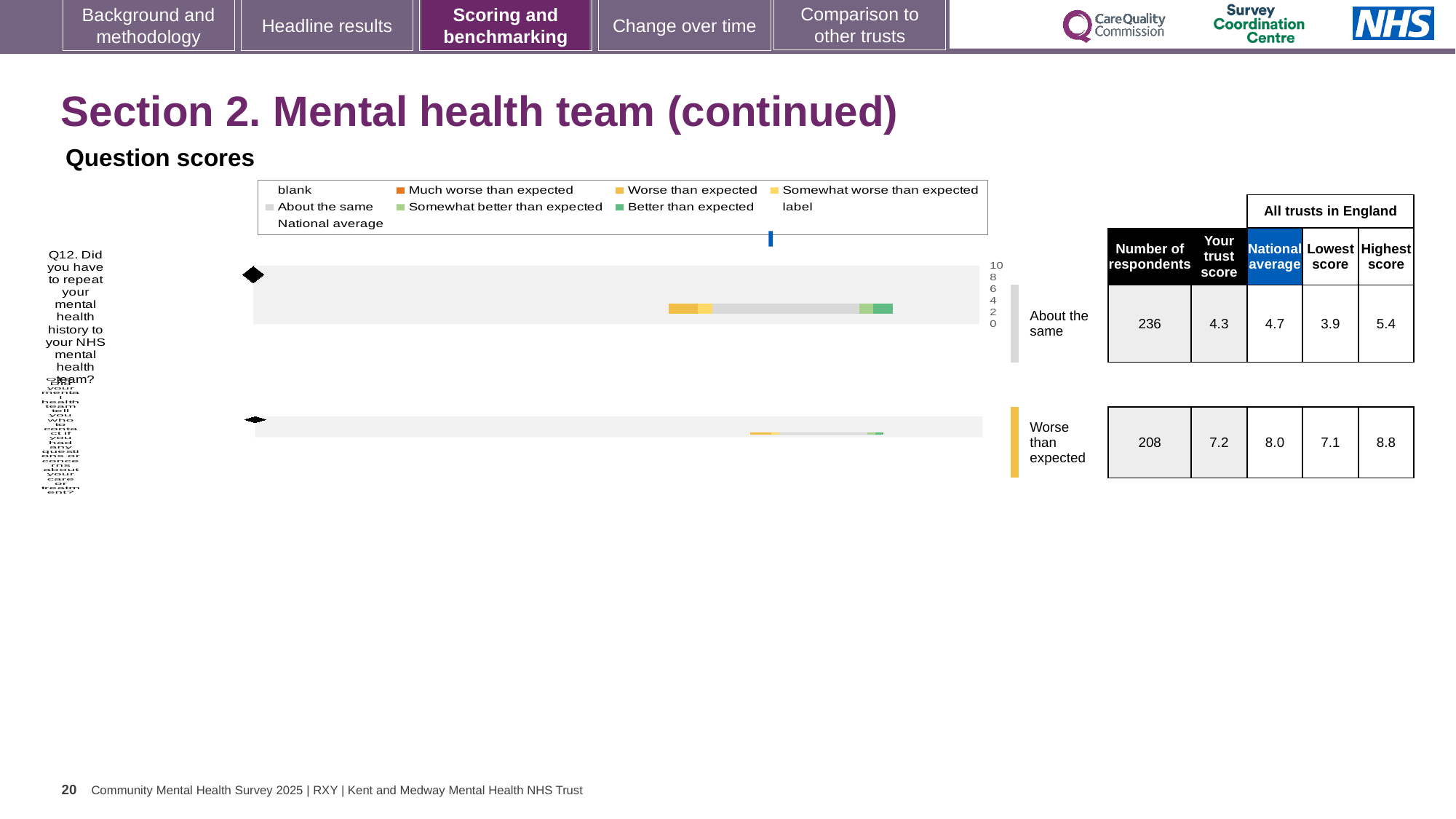
What is the difference between the highest score (5.4) and the lowest score (3.9) for Q12? 1.5 What is the national average for Q12? 4.7 How many questions are plotted on the chart? 2 What is the trust's score for the second question, the one rated 'Worse than expected'? 7.2 What benchmark category is shown for Q12? About the same How many respondents are shown for Q12 (repeating your mental health history to your NHS mental health team)? 236 For Q12, which is larger: the trust's score or the national average? National average What kind of chart is used to show the question scores? Bar chart What is the national average for the question rated 'Worse than expected'? 8.0 What is the highest score among all trusts in England for Q12? 5.4 What is the trust's score for Q12? 4.3 For the question rated 'Worse than expected', how much higher is the national average (8.0) than the trust's score (7.2)? 0.8